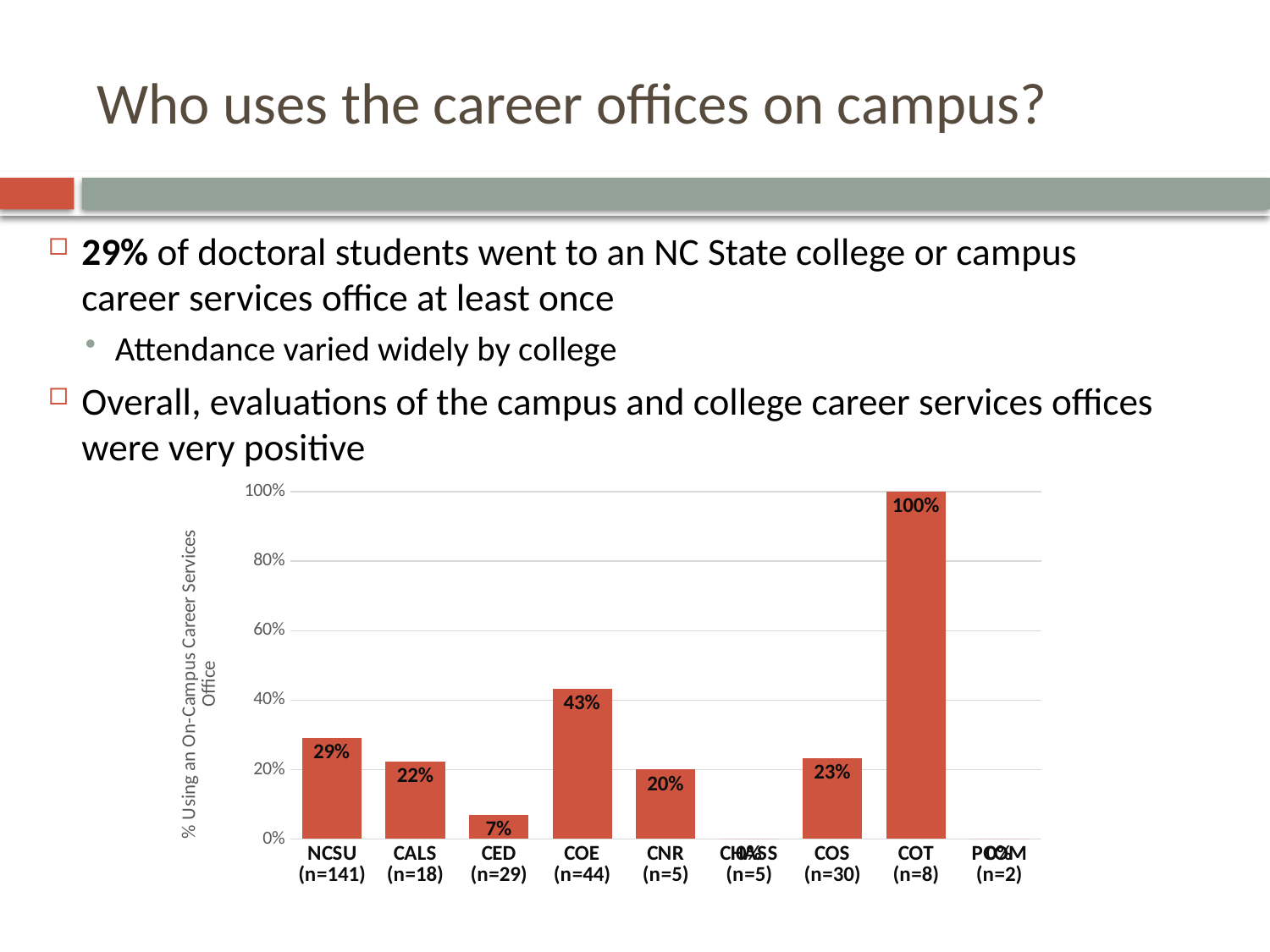
What is the value for CED (n=29)? 7% What is the difference between the values for COE (n=44) and CALS (n=18)? 21% What is the value for COS (n=30)? 23% Is the value for COE (n=44) greater or less than 40%? greater What kind of chart is shown on the slide? bar chart Which is larger, the value for CNR (n=5) or the value for CED (n=29)? CNR (n=5) How many categories are shown on the x axis of the chart? 9 What is the label of the vertical axis of the chart? % Using an On-Campus Career Services Office What is the difference between the values for COT (n=8) and NCSU (n=141)? 71% What is the value for COE (n=44)? 43% What is the value for NCSU (n=141)? 29% Which college has the highest percentage using an on-campus career services office? COT (n=8)